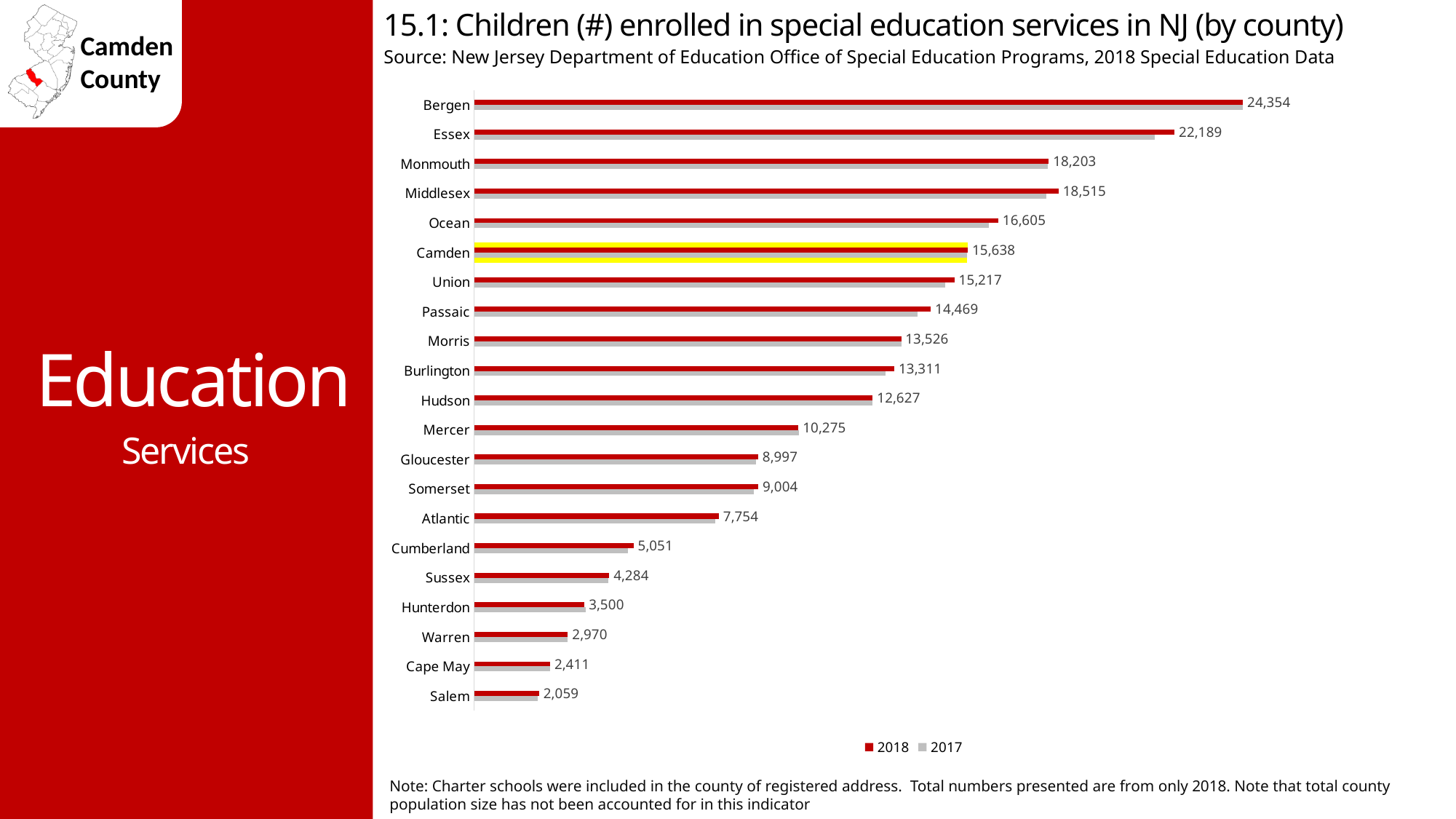
What kind of chart is shown on the slide? Bar chart How many children were enrolled in special education services in Bergen in 2018? 24,354 What is the difference between the 2018 values for Bergen and Essex? 2,165 Which county has the lowest 2018 value in the chart? Salem What is the 2018 value for Camden in the chart? 15,638 What is the 2018 value shown for Gloucester? 8,997 Which has the larger 2018 value, Middlesex or Monmouth? Middlesex How many counties are shown in the chart? 21 Which has the larger 2018 value, Somerset or Gloucester? Somerset What is the difference between the 2018 values for Camden and Union? 421 Which county has the highest 2018 value in the chart? Bergen How many series does the legend list? 2